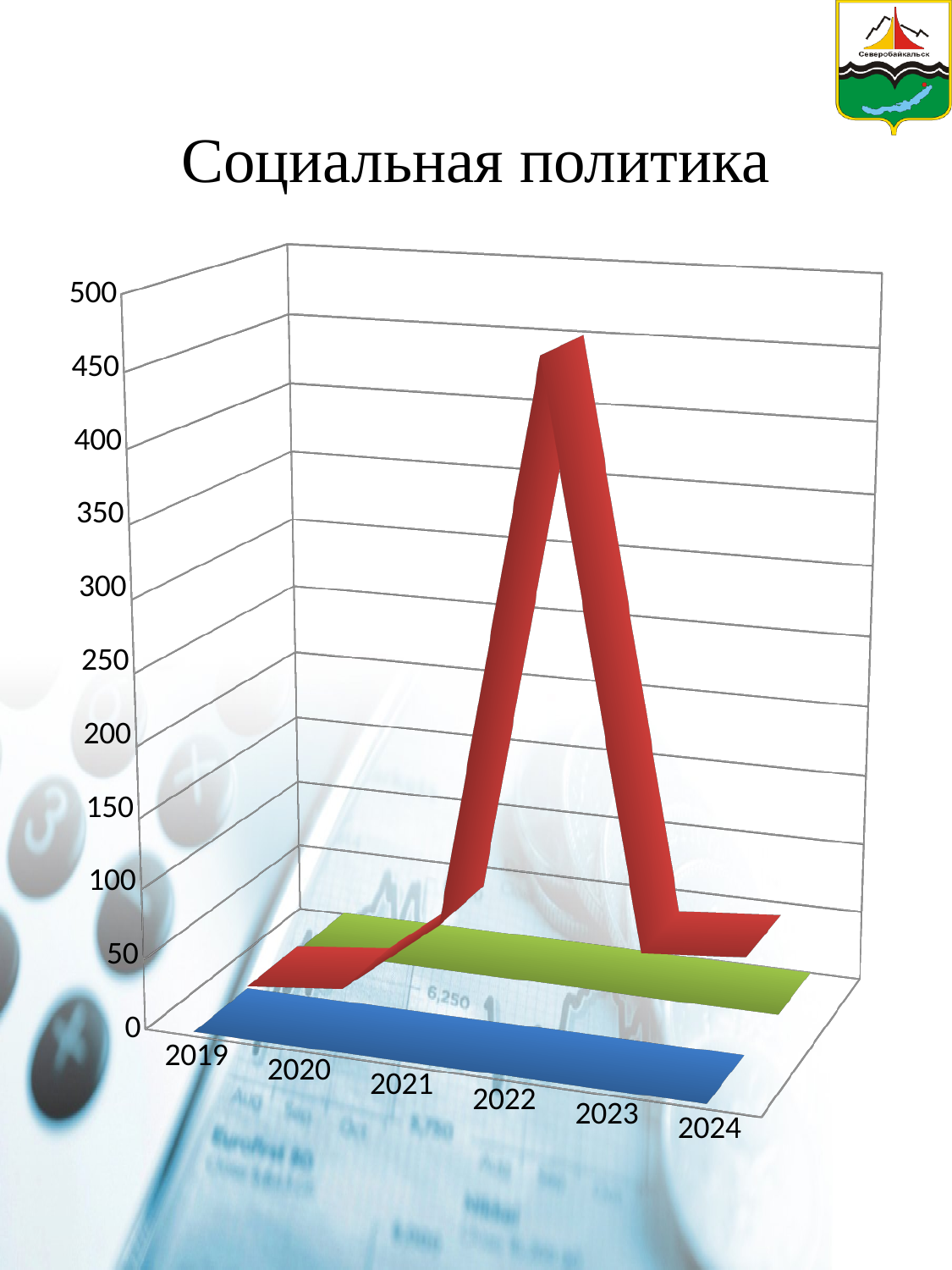
What kind of chart is shown on the slide? line chart Is the value of the red line in 2019 greater or less than 100? less What is the highest value shown on the vertical axis? 500 Which is larger for the red line: the value in 2022 or the value in 2023? 2022 Does the red line rise or fall from 2022 to 2023? fall What is the title of the chart? Социальная политика Is the value of the red line in 2024 greater or less than 100? less In which year does the red line reach its highest value? 2022 What is the first year shown on the x axis? 2019 How many years are shown on the x axis of the chart? 6 Is the value of the blue line in 2022 greater or less than 50? less